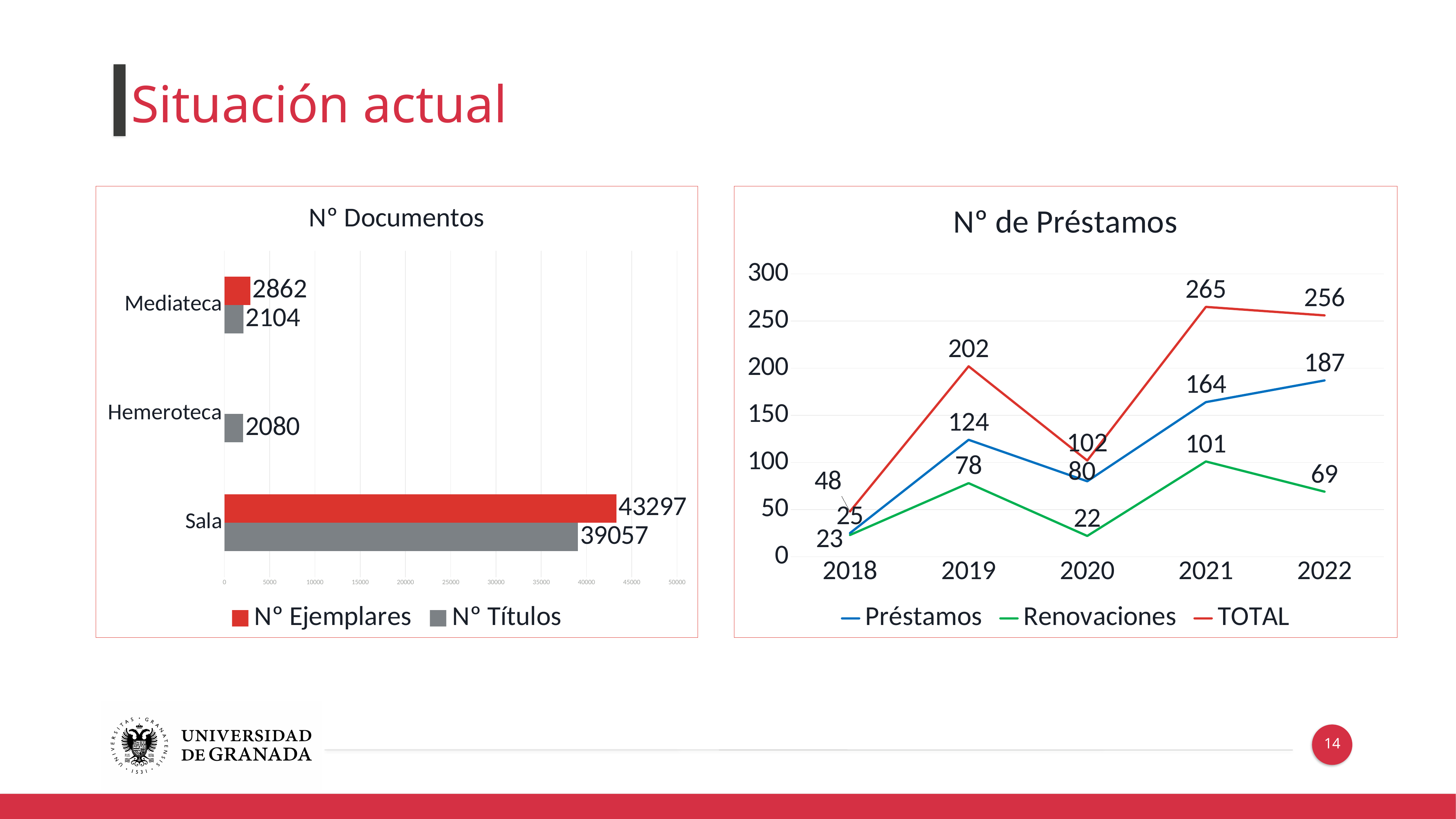
In the 'N° de Préstamos' chart, what is the difference between the TOTAL values for 2019 and 2020? 100 In the 'N° de Préstamos' chart, what is the Renovaciones value for 2020? 22 In the 'N° Documentos' chart, what is the N° Títulos value for Mediateca? 2104 In the 'N° Documentos' chart, which category has the highest N° Títulos value? Sala In the 'N° de Préstamos' chart, which series is drawn in green? Renovaciones In the 'N° Documentos' chart, what kind of chart is shown? Bar chart In the 'N° Documentos' chart, how many series does the legend list? 2 In the 'N° de Préstamos' chart, which year has the lowest Préstamos value? 2018 In the 'N° Documentos' chart, what is the difference between N° Ejemplares and N° Títulos for Sala? 4240 In the 'N° de Préstamos' chart, what is the TOTAL value for 2021? 265 In the 'N° Documentos' chart, what is the N° Ejemplares value for Sala? 43297 In the 'N° de Préstamos' chart, how many years are plotted on the x axis? 5